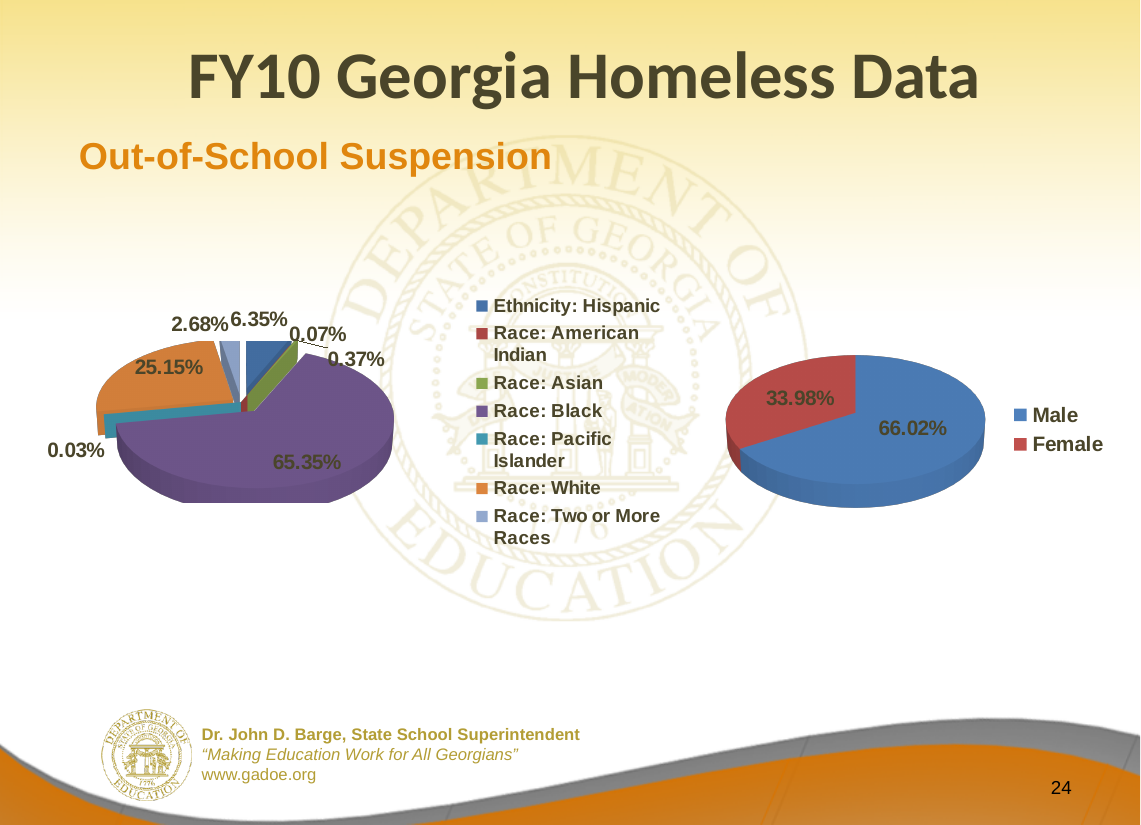
In the left pie chart (race/ethnicity), what percentage is shown for Race: Black? 65.35% In the left pie chart (race/ethnicity), what percentage is shown for Race: Two or More Races? 2.68% In the left pie chart (race/ethnicity), how many categories does the legend list? 7 In the right pie chart (gender), what percentage is shown for Male? 66.02% In the left pie chart (race/ethnicity), which category has the largest share? Race: Black What type of chart is used for the gender data on the right? Pie chart In the right pie chart (gender), what percentage is shown for Female? 33.98% In the left pie chart (race/ethnicity), what is the difference between the Race: Black and Race: White percentages? 40.20% In the right pie chart (gender), which is larger, Male or Female? Male In the left pie chart (race/ethnicity), what percentage is shown for Race: White? 25.15% In the left pie chart (race/ethnicity), what percentage is shown for Ethnicity: Hispanic? 6.35% In the left pie chart (race/ethnicity), which category has the smallest share? Race: Pacific Islander